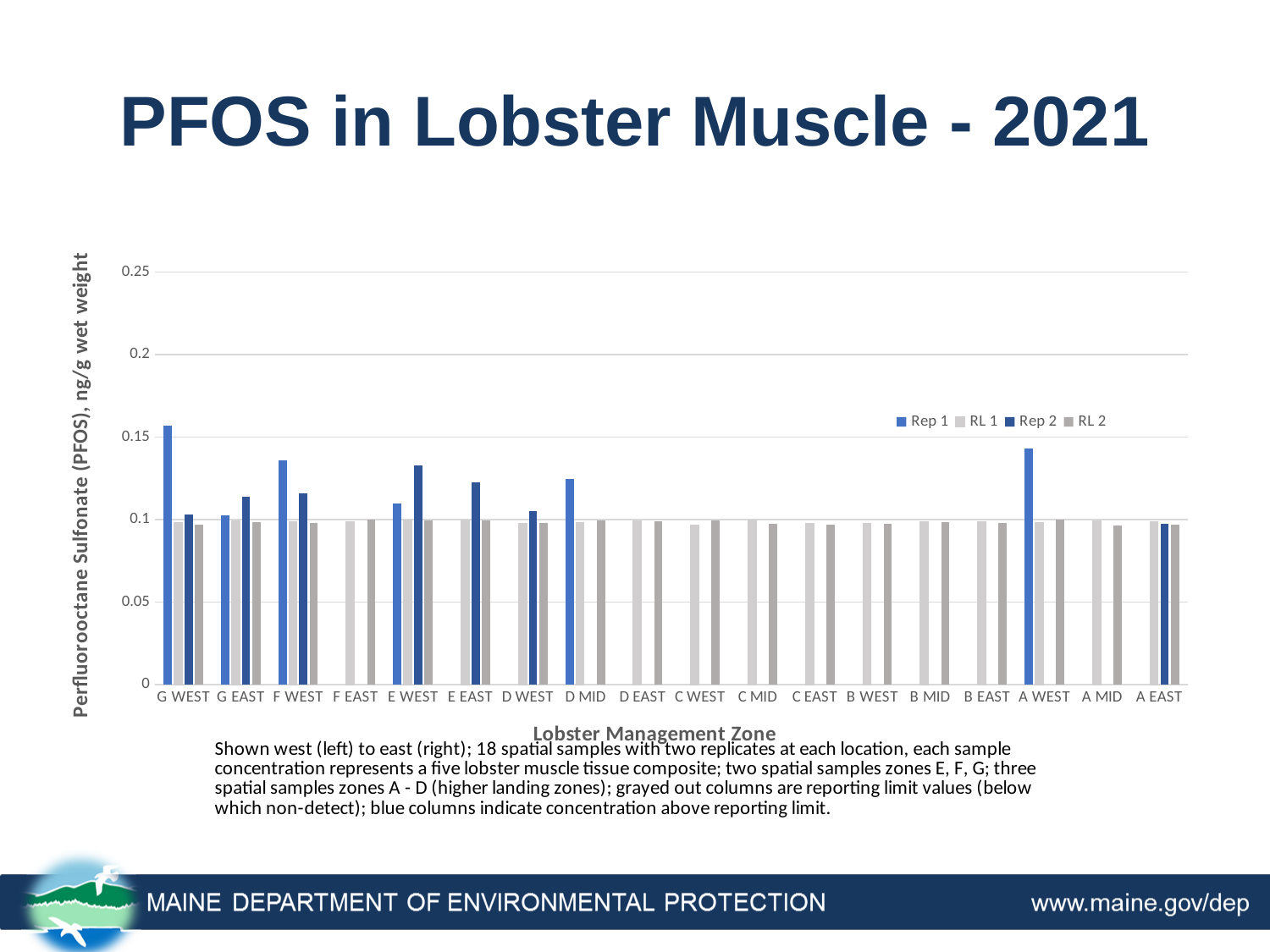
Is the Rep 1 value for G WEST greater or less than 0.15? greater Which is larger, the Rep 2 value for E WEST or the Rep 2 value for D WEST? E WEST What is the label of the x axis? Lobster Management Zone Which is larger, the Rep 1 value for F WEST or the Rep 1 value for E WEST? F WEST Is the Rep 1 value for F WEST greater or less than 0.1? greater What kind of chart is shown on the slide? bar chart How many series does the chart legend list? 4 What is the title of the chart on the slide? PFOS in Lobster Muscle - 2021 How many lobster management zones are shown on the x axis? 18 Is the Rep 2 value for E WEST greater or less than 0.1? greater Which zone has the highest Rep 1 value? G WEST